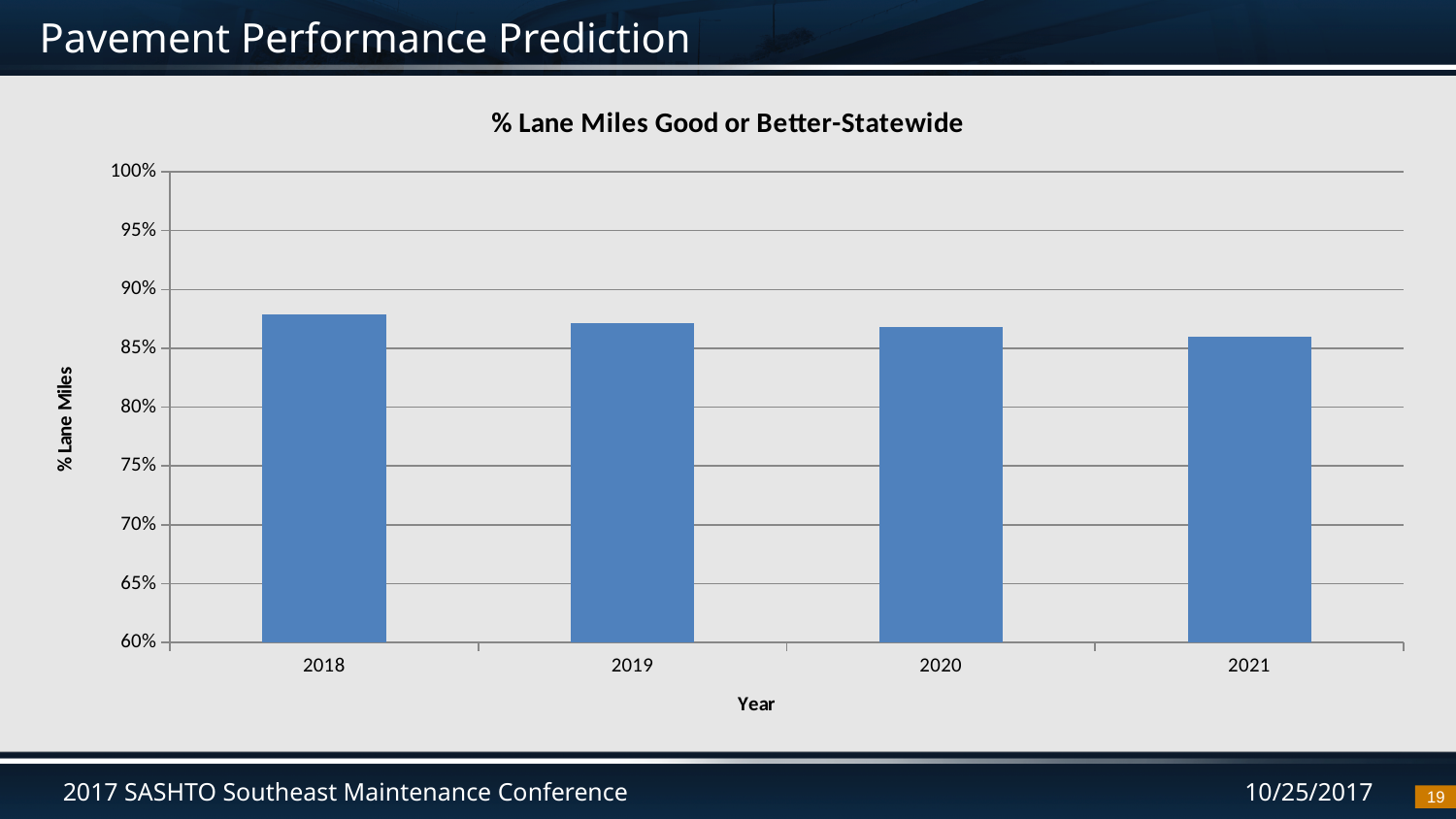
Do the values rise or fall from 2018 to 2021? fall Which year has the highest % Lane Miles Good or Better? 2018 Which year has the lowest % Lane Miles Good or Better? 2021 What kind of chart is shown on the slide? bar chart How many years are plotted on the chart? 4 What is the label on the x axis of the chart? Year Is the value for 2020 greater or less than 85%? greater What is the title of the chart? % Lane Miles Good or Better-Statewide Is the value for 2021 greater or less than 90%? less Which is larger, the value for 2018 or the value for 2021? 2018 Is the value for 2018 greater or less than 85%? greater